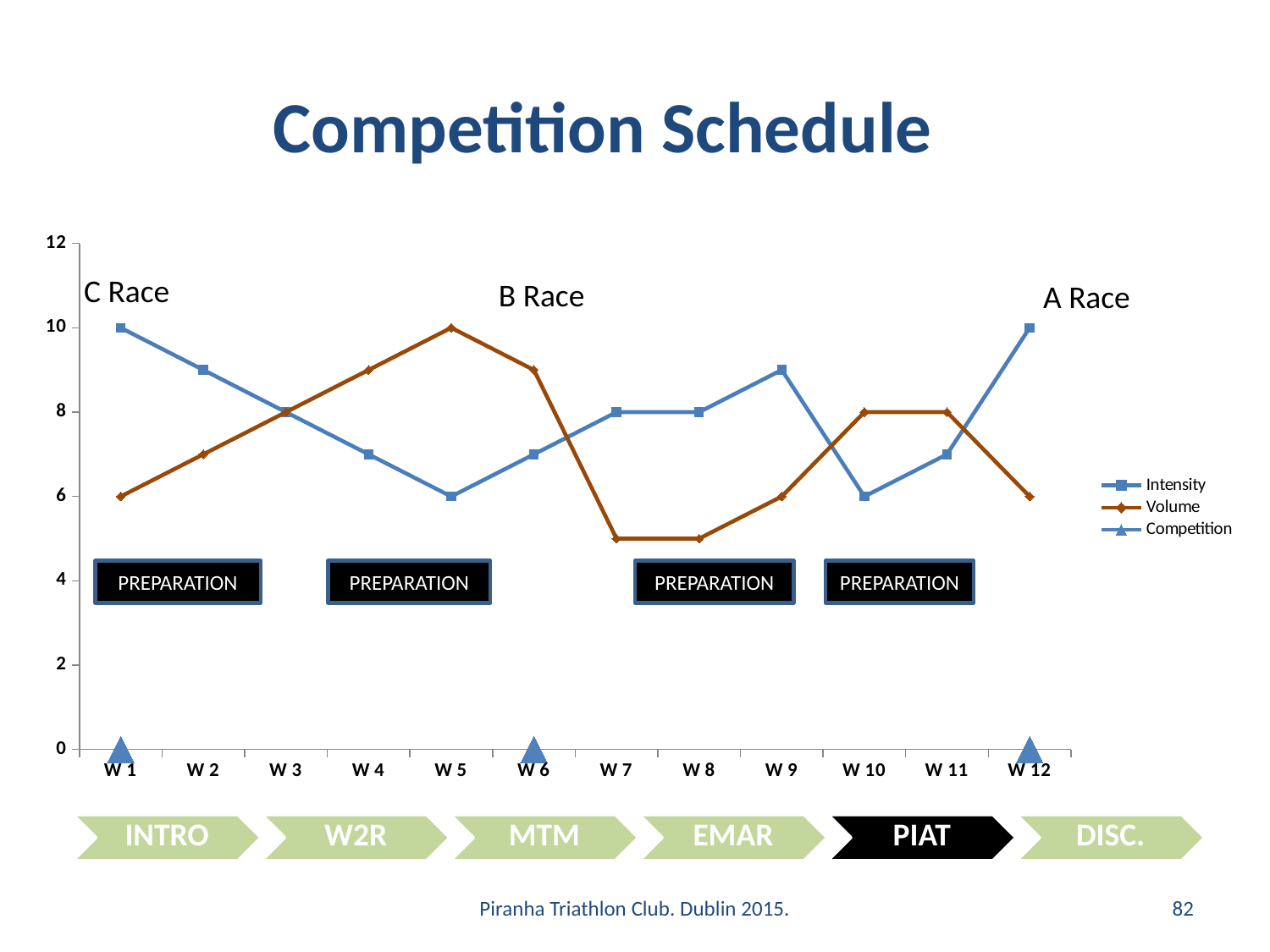
What is the Volume value at W 5? 10 At which week does the Volume series reach its highest value? W 5 What is the Volume value at W 12? 6 What is the Intensity value at W 5? 6 What kind of chart is shown on the slide? line chart Is the Volume value at W 7 greater or less than 6? less What is the Intensity value at W 1? 10 How many series does the legend list? 3 At W 5, which is larger, Intensity or Volume? Volume How many weeks are shown on the x axis? 12 Does the Intensity series rise or fall from W 1 to W 5? fall Is the Intensity value at W 9 greater or less than 8? greater